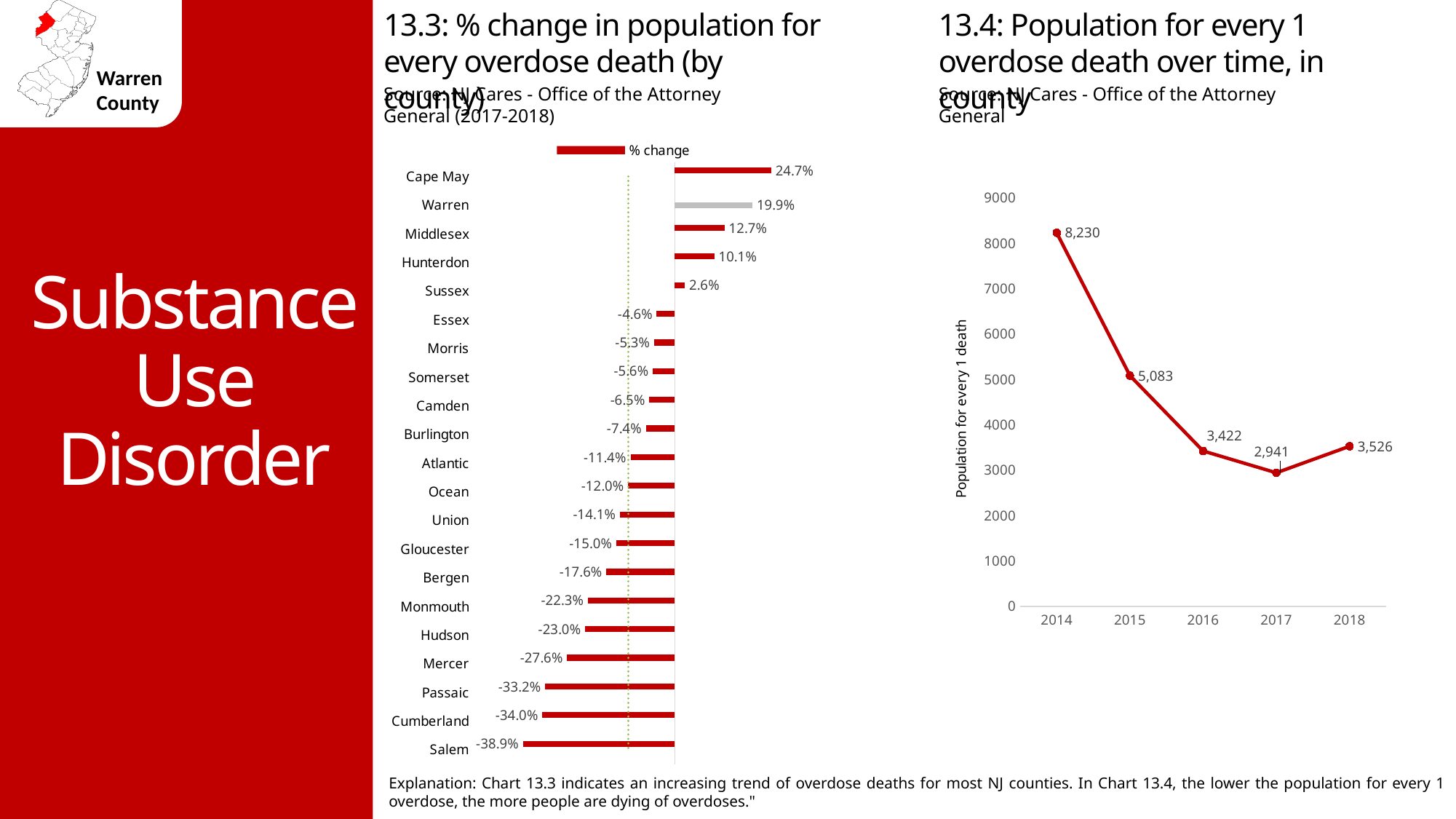
In chart 13.4, what is the label of the y axis? Population for every 1 death In chart 13.3, which county has the highest % change? Cape May In chart 13.3, what is the value for Hudson? -23.0% In chart 13.3, how many counties are shown? 21 In chart 13.4, which year has the lowest population for every 1 overdose death? 2017 In chart 13.4, what is the difference between the values for 2014 and 2015? 3,147 In chart 13.3, what is the difference between the values for Cape May and Warren? 4.8 percentage points In chart 13.3, which is larger, the value for Middlesex or the value for Hunterdon? Middlesex In chart 13.4 (Population for every 1 overdose death over time), what is the value for 2014? 8,230 In chart 13.3 (% change in population for every overdose death), what is the value for Warren? 19.9% In chart 13.3, which county has the lowest % change? Salem What kind of chart is chart 13.3? Bar chart